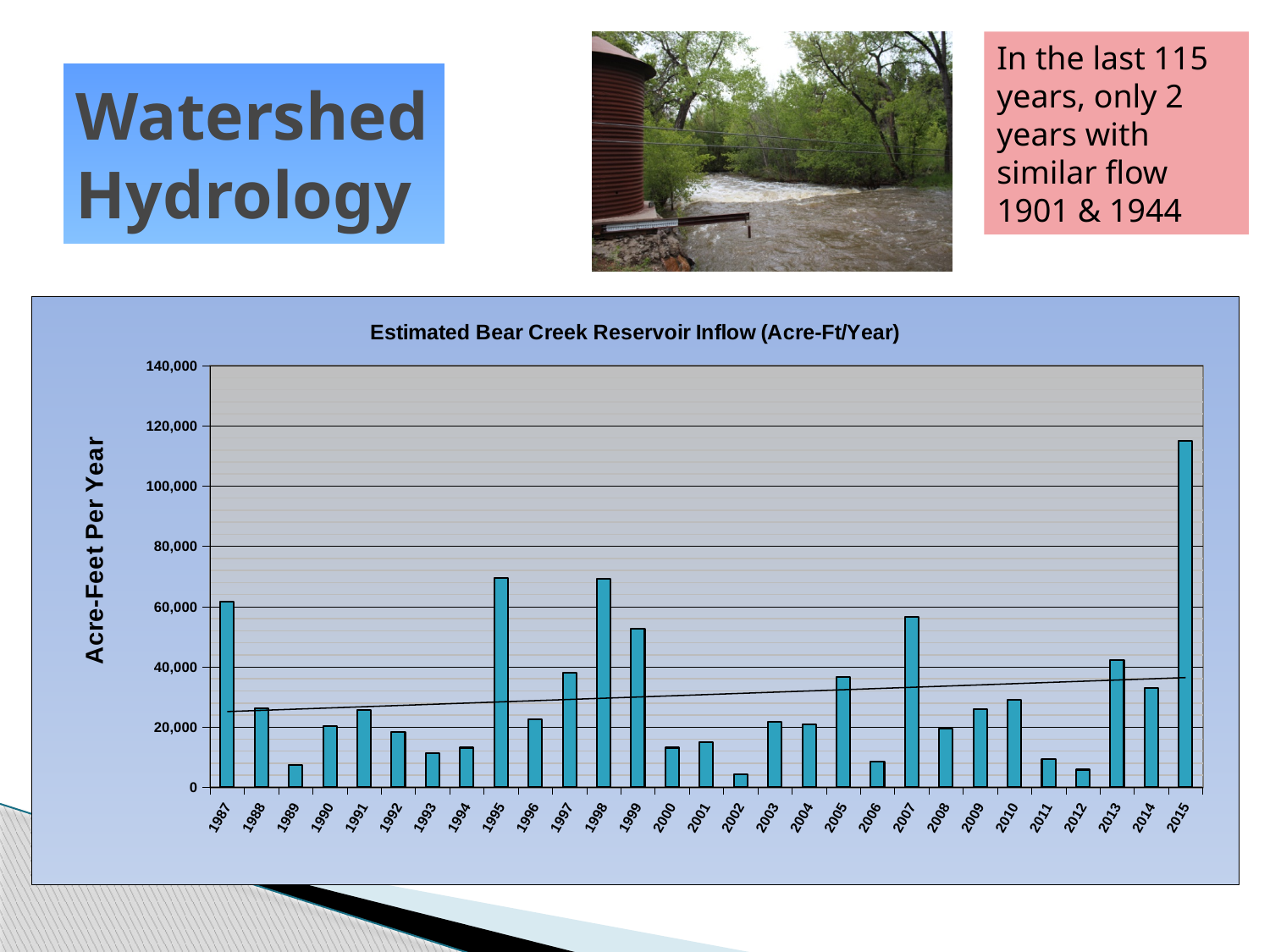
What is the label on the vertical axis of the chart? Acre-Feet Per Year Is the value for 1987 greater or less than 40,000? greater Which year has the lowest estimated inflow? 2002 Is the value for 2015 greater or less than 100,000? greater Which year has the larger inflow, 2006 or 2007? 2007 Is the value for 1995 greater or less than 60,000? greater How many years are plotted on the x axis of the chart? 29 What kind of chart is shown on the slide? bar chart What is the title of the chart? Estimated Bear Creek Reservoir Inflow (Acre-Ft/Year) Which year has the highest estimated inflow? 2015 Which year has the larger inflow, 1995 or 1996? 1995